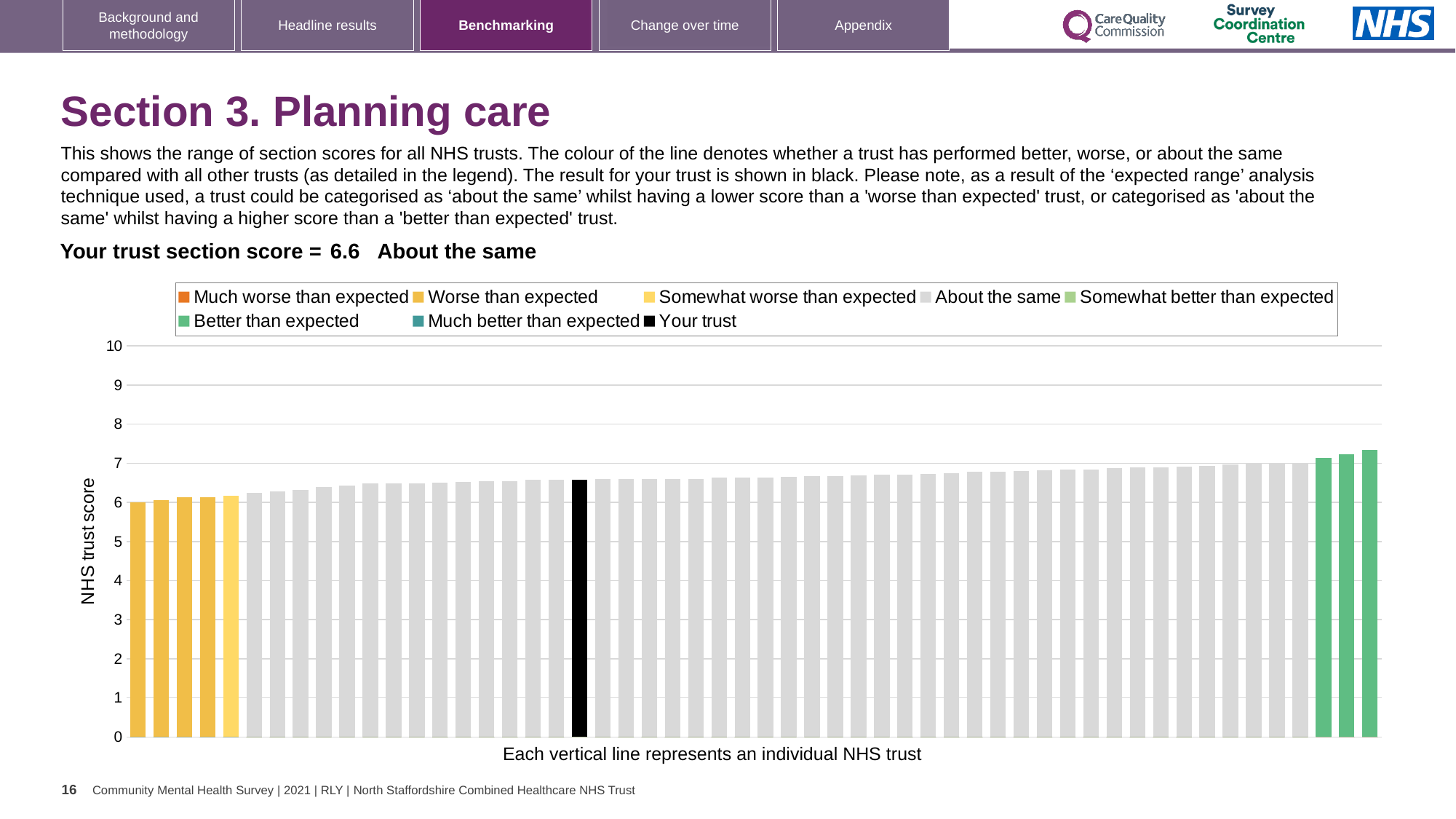
Is the value for the lowest-scoring trust greater or less than 7? less How many trusts are shown as 'Better than expected' (green bars)? 3 Which legend category do the lowest-scoring trusts on the chart belong to? Worse than expected Do the trust scores rise or fall moving from left to right along the x axis? rise What is the label on the vertical axis of the chart? NHS trust score Which legend category do the highest-scoring trusts on the chart belong to? Better than expected What is the section score for your trust? 6.6 What kind of chart is shown on the slide? Bar chart Is the value for the highest-scoring trust greater or less than 7? greater Which category is your trust's section score placed in? About the same Is the value for your trust greater or less than 7? less How many entries does the chart legend list? 8